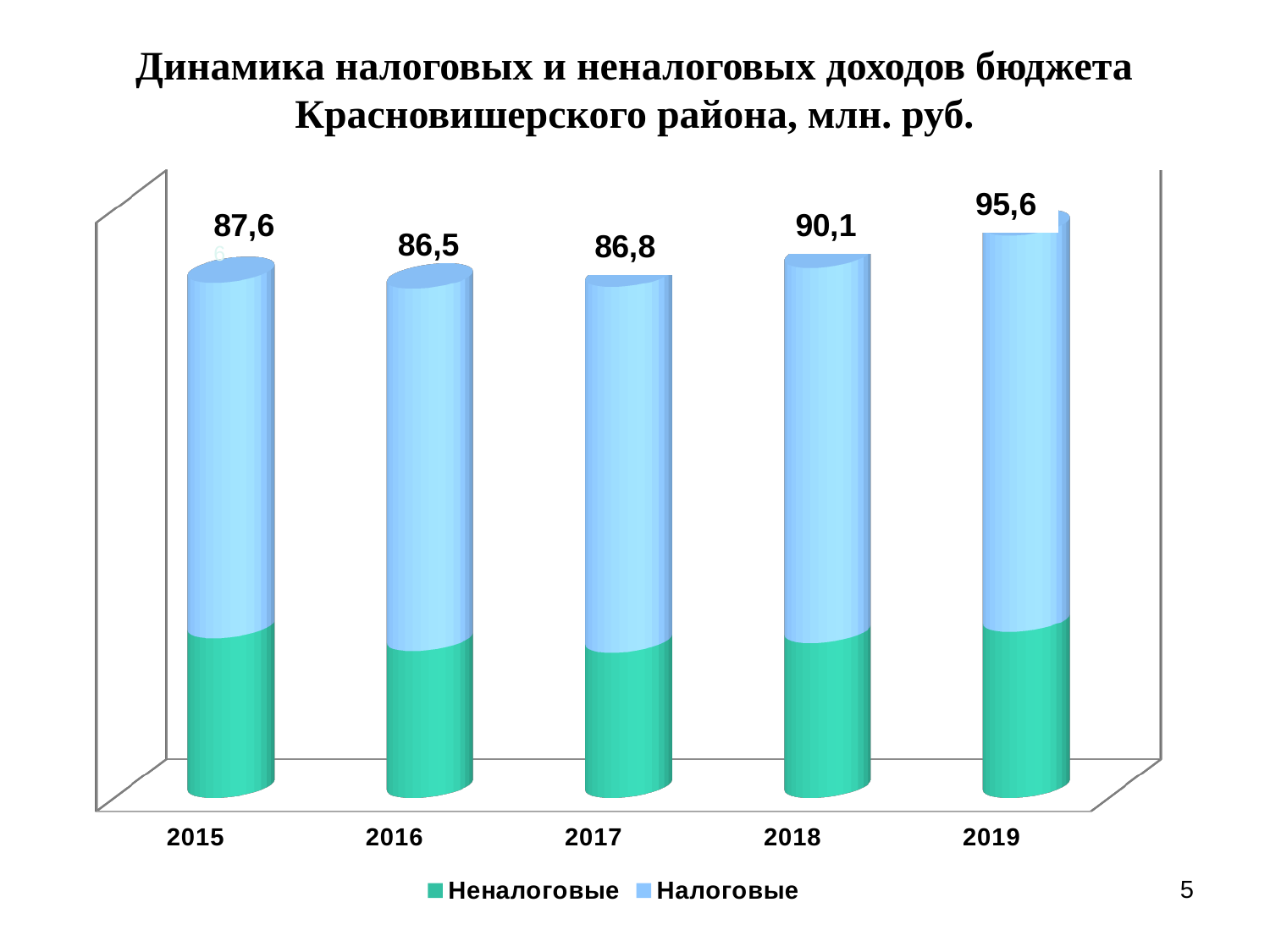
How many years are shown on the x axis? 5 How many series does the legend list? 2 What is the total labelled on the bar for 2019? 95,6 What is the total labelled on the bar for 2015? 87,6 What is the total labelled on the bar for 2017? 86,8 What is the difference between the totals for 2019 and 2015? 8,0 What kind of chart is shown on the slide? Stacked bar chart Which year has the lowest total? 2016 Which series is shown in green according to the legend? Неналоговые Which year has the highest total? 2019 Which total is larger, 2016 or 2017? 2017 What is the difference between the totals for 2018 and 2016? 3,6